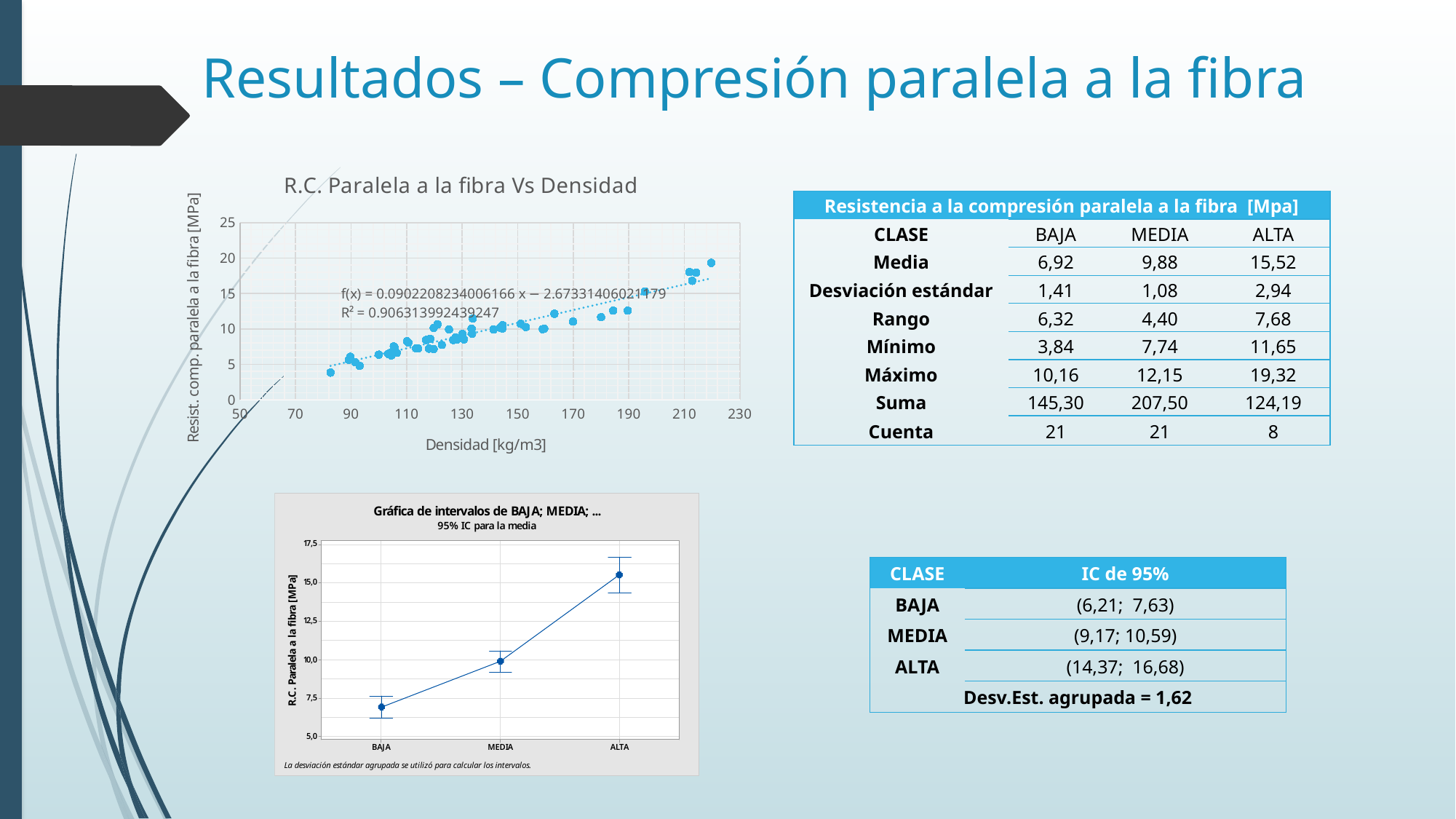
What kind of chart is the chart titled "R.C. Paralela a la fibra Vs Densidad"? Scatter chart In the interval chart at the bottom left of the slide, which class has the highest mean? ALTA In the chart titled "R.C. Paralela a la fibra Vs Densidad", is the value of the point with the highest density greater or less than 15? greater In the chart titled "R.C. Paralela a la fibra Vs Densidad", do the values rise or fall as density increases? Rise In the chart titled "R.C. Paralela a la fibra Vs Densidad", what R² value is shown for the trendline? R² = 0.906313992439247 How many categories are shown on the x axis of the interval chart at the bottom left of the slide? 3 In the interval chart at the bottom left of the slide, is the mean for ALTA greater or less than 12,5? greater In the chart titled "R.C. Paralela a la fibra Vs Densidad", what is the label of the x axis? Densidad [kg/m3] In the interval chart at the bottom left of the slide, is the mean for BAJA greater or less than 7,5? less In the interval chart at the bottom left of the slide, do the means rise or fall from BAJA to ALTA? Rise In the interval chart at the bottom left of the slide, which class has the lowest mean? BAJA